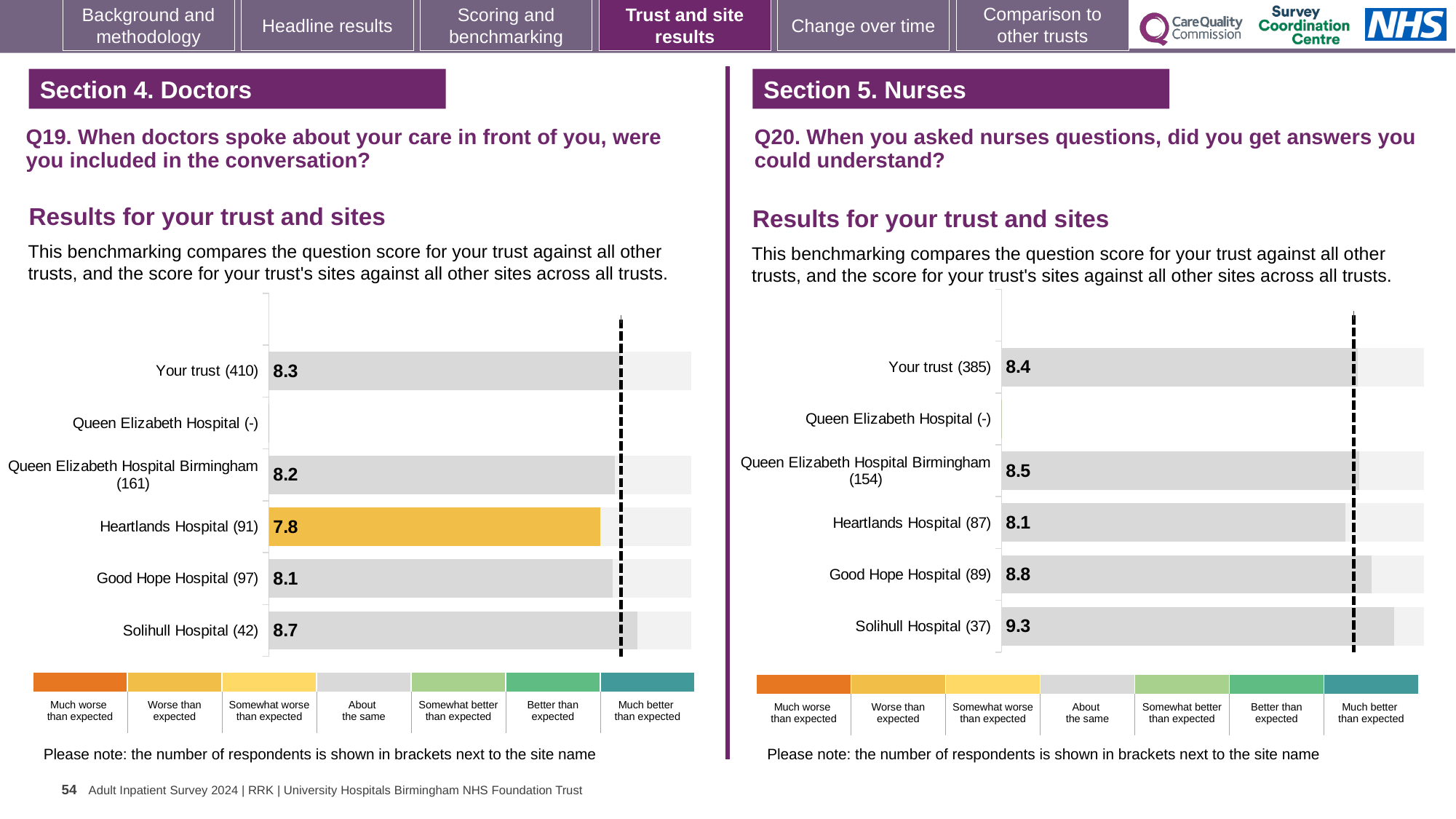
In the Q20 chart on the right, which is larger, the score for Good Hope Hospital (89) or Your trust (385)? Good Hope Hospital (89) In the Q19 chart on the left, what is the difference between the scores for Solihull Hospital (42) and Good Hope Hospital (97)? 0.6 In the Q19 chart on the left, what is the score for Heartlands Hospital (91)? 7.8 In the Q20 chart on the right, what is the score for Queen Elizabeth Hospital Birmingham (154)? 8.5 In the Q19 chart on the left, what colour is the bar for Heartlands Hospital (91)? Orange/yellow (worse than expected) In the Q20 chart on the right, what is the score for Solihull Hospital (37)? 9.3 In the Q20 chart on the right, what is the difference between the scores for Solihull Hospital (37) and Heartlands Hospital (87)? 1.2 What type of chart is used in the Q20 chart on the right? Bar chart In the Q19 chart on the left, which site has the lowest score? Heartlands Hospital (91) In the Q20 chart on the right, which site has the lowest score? Heartlands Hospital (87) In the Q19 chart on the left, which site has the highest score? Solihull Hospital (42) In the Q19 chart on the left, what is the score for Your trust (410)? 8.3